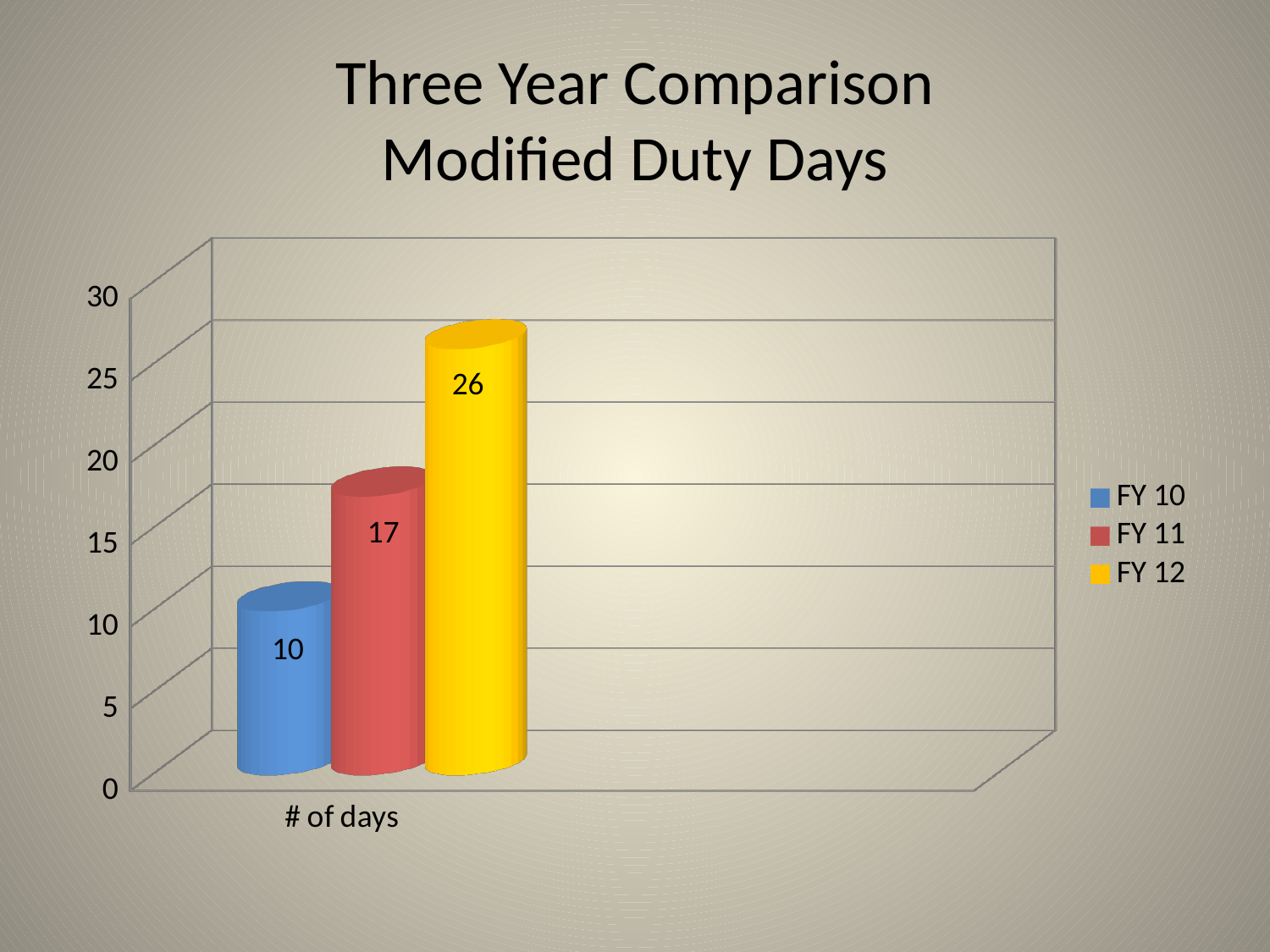
Which series has the highest value? FY 12 What is the value for FY 10? 10 What is the value for FY 12? 26 What is the label on the x axis category? # of days What is the difference between the FY 12 and FY 10 values? 16 Which is larger, the value for FY 11 or the value for FY 12? FY 12 Is the value for FY 11 greater or less than 15? greater What is the value for FY 11? 17 What kind of chart is shown on the slide? bar chart What is the difference between the FY 11 and FY 10 values? 7 How many series does the legend list? 3 Which series has the lowest value? FY 10